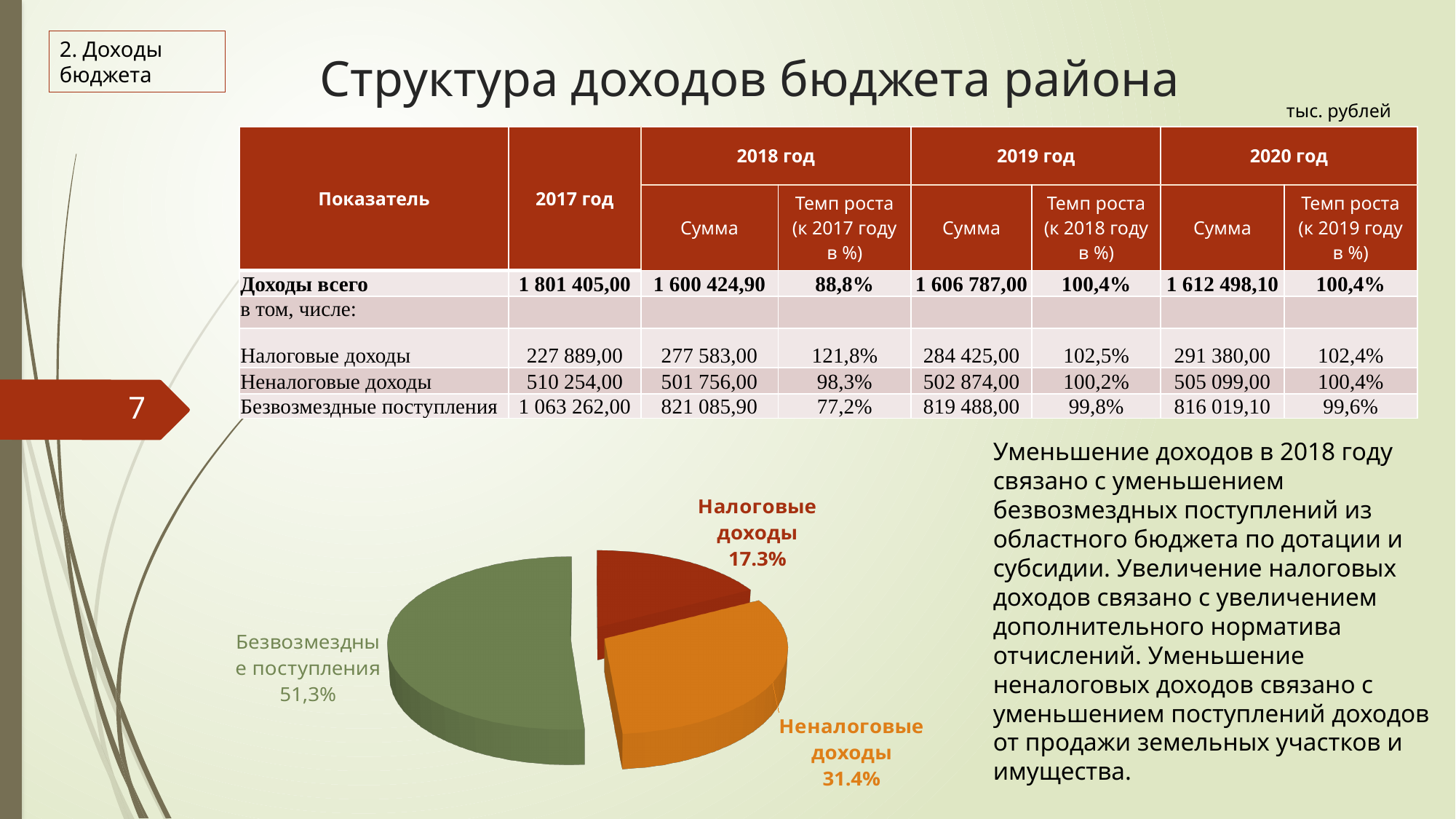
What kind of chart is shown on the slide? Pie chart What share of the pie chart is labelled for Безвозмездные поступления? 51,3% How many slices does the pie chart have? 3 In the pie chart, which is larger: Неналоговые доходы or Налоговые доходы? Неналоговые доходы Which slice of the pie chart is the smallest? Налоговые доходы What colour is the Безвозмездные поступления slice in the pie chart? Green What share of the pie chart is labelled for Неналоговые доходы? 31.4% What colour is the Неналоговые доходы slice in the pie chart? Orange Which slice of the pie chart is the largest? Безвозмездные поступления What share of the pie chart is labelled for Налоговые доходы? 17.3% In the pie chart, which is larger: Безвозмездные поступления or Неналоговые доходы? Безвозмездные поступления